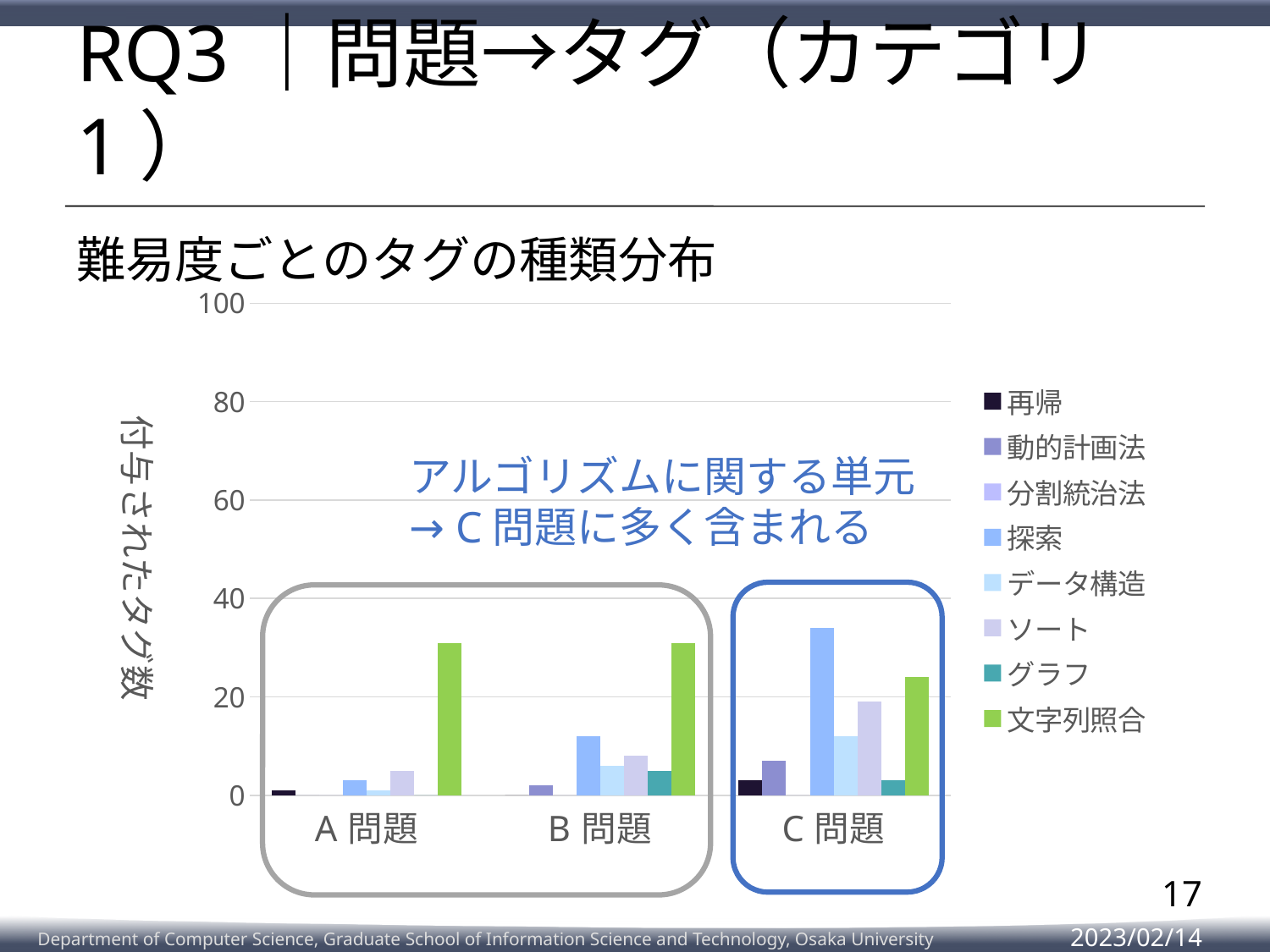
Which is larger: the 探索 bar for C 問題 or the 探索 bar for A 問題? C 問題 Is the value of 探索 for C 問題 greater or less than 40? less What kind of chart is shown on the slide? bar chart Is the value of 文字列照合 for A 問題 greater or less than 20? greater How many series does the chart's legend list? 8 Which series has the highest bar for C 問題? 探索 Is the value of 探索 for B 問題 greater or less than 20? less Which series has the highest bar for A 問題? 文字列照合 What is the label of the chart's vertical axis? 付与されたタグ数 What is the title shown above the chart? 難易度ごとのタグの種類分布 How many categories are shown on the x axis of the chart? 3